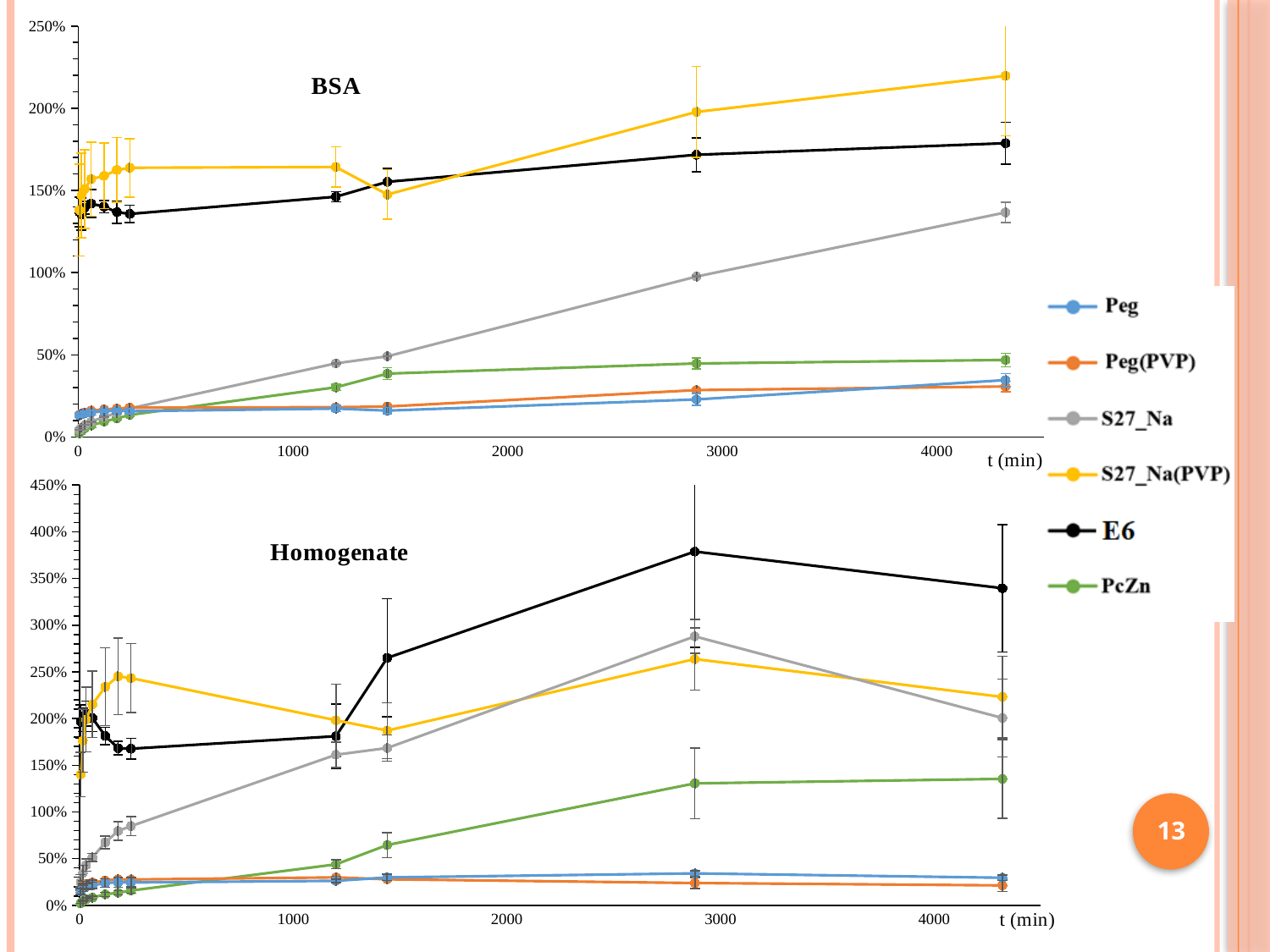
In the BSA chart, which series has the highest value at the last time point (around 4300 min)? S27_Na(PVP) In the Homogenate chart, which is larger at the last time point (around 4300 min): PcZn or Peg? PcZn In the Homogenate chart, does the S27_Na series rise or fall between around 2900 min and around 4300 min? falls What kind of chart is the BSA chart at the top of the slide? line chart What is the label on the x axis of both charts? t (min) In the Homogenate chart, is the value of E6 at around 2900 min greater or less than 350%? greater In the BSA chart, is the value of S27_Na at the last time point (around 4300 min) greater or less than 100%? greater What is the highest value shown on the y axis of the Homogenate chart? 450% In the Homogenate chart, which series has the highest value at around 2900 min? E6 In the BSA chart, does the S27_Na series rise or fall as time increases along the x axis? rises In the BSA chart, is the value of E6 at the last time point (around 4300 min) greater or less than 150%? greater How many series does the legend list? 6